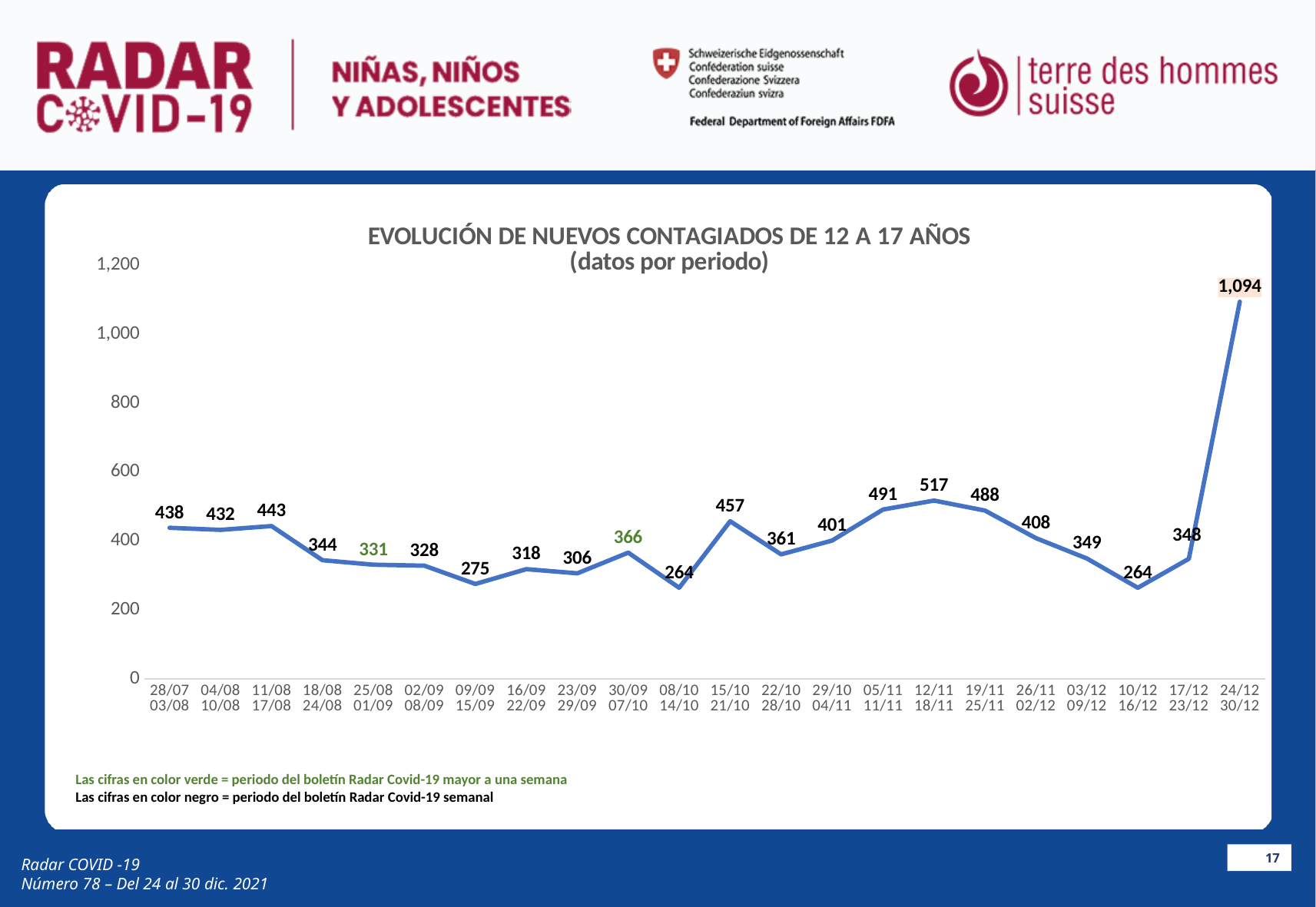
What is the title of the chart? EVOLUCIÓN DE NUEVOS CONTAGIADOS DE 12 A 17 AÑOS (datos por periodo) How many periods (data points) are plotted on the chart? 22 Which is larger, the value for 15/10–21/10 or the value for 22/10–28/10? 15/10–21/10 What type of chart is shown on the slide? line chart What is the lowest value plotted on the chart? 264 Which period has the highest value? 24/12–30/12 What is the value for the period 24/12–30/12? 1,094 What is the value for the period 12/11–18/11? 517 What is the difference between the values for 24/12–30/12 and 17/12–23/12? 746 What is the value for the period 09/09–15/09? 275 Do the values rise or fall between 10/12–16/12 and 24/12–30/12? rise What is the value for the period 25/08–01/09? 331